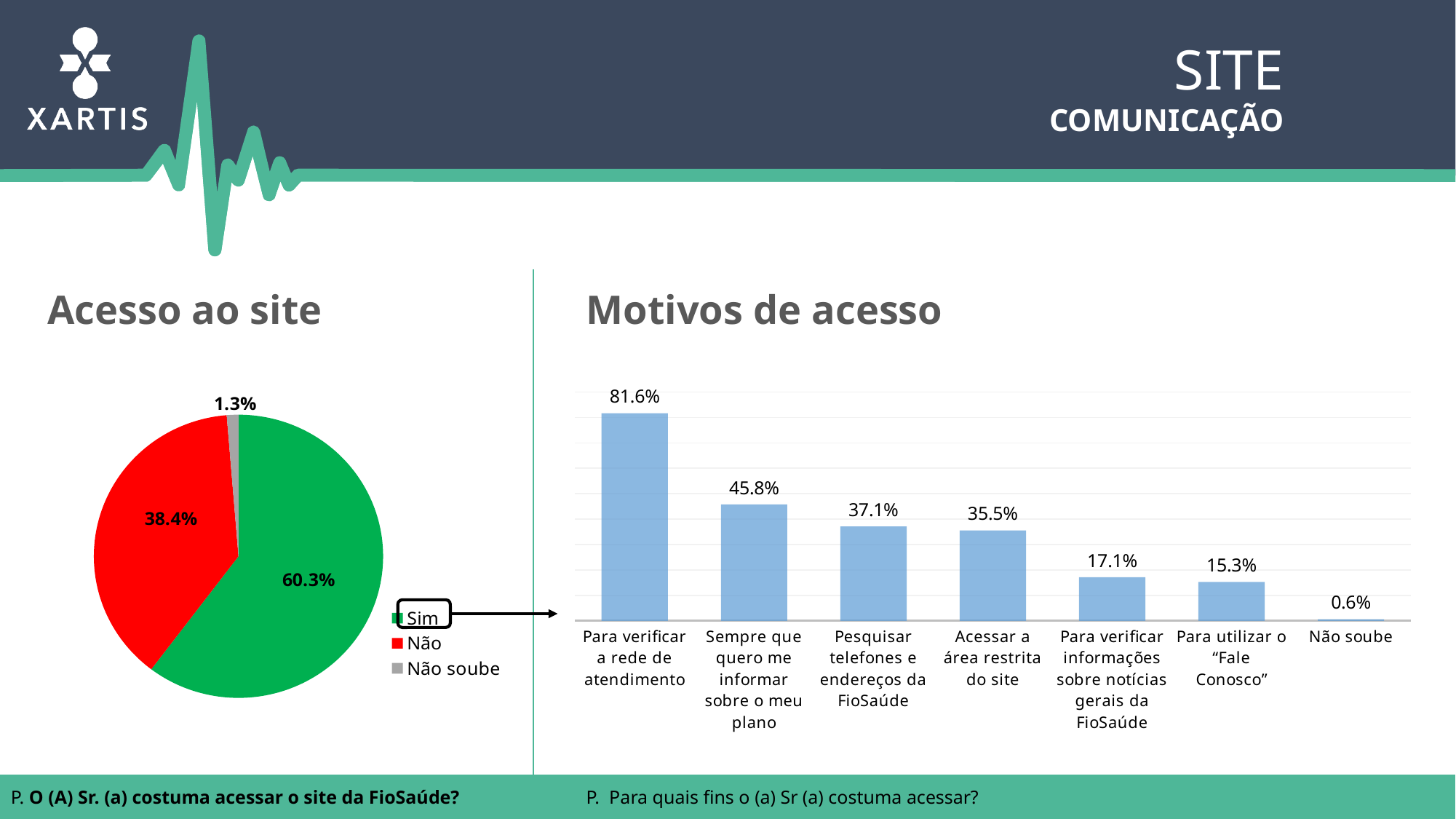
In the 'Acesso ao site' pie chart, which slice is the smallest? Não soube What type of chart is 'Acesso ao site'? Pie chart What type of chart is 'Motivos de acesso'? Bar chart In the 'Acesso ao site' pie chart, what is the difference between the 'Sim' and 'Não' slices? 21.9% In the 'Motivos de acesso' chart, what is the value for 'Para verificar a rede de atendimento'? 81.6% In the 'Motivos de acesso' chart, which category has the highest value? Para verificar a rede de atendimento In the 'Motivos de acesso' chart, what is the value for 'Acessar a área restrita do site'? 35.5% In the 'Motivos de acesso' chart, what is the difference between 'Sempre que quero me informar sobre o meu plano' and 'Para verificar informações sobre notícias gerais da FioSaúde'? 28.7% In the 'Acesso ao site' pie chart, what share of respondents answered 'Sim'? 60.3% In the 'Acesso ao site' pie chart, how many slices are there? 3 In the 'Motivos de acesso' chart, which is larger: 'Pesquisar telefones e endereços da FioSaúde' or 'Para utilizar o "Fale Conosco"'? Pesquisar telefones e endereços da FioSaúde In the 'Acesso ao site' pie chart, what is the value for 'Não'? 38.4%